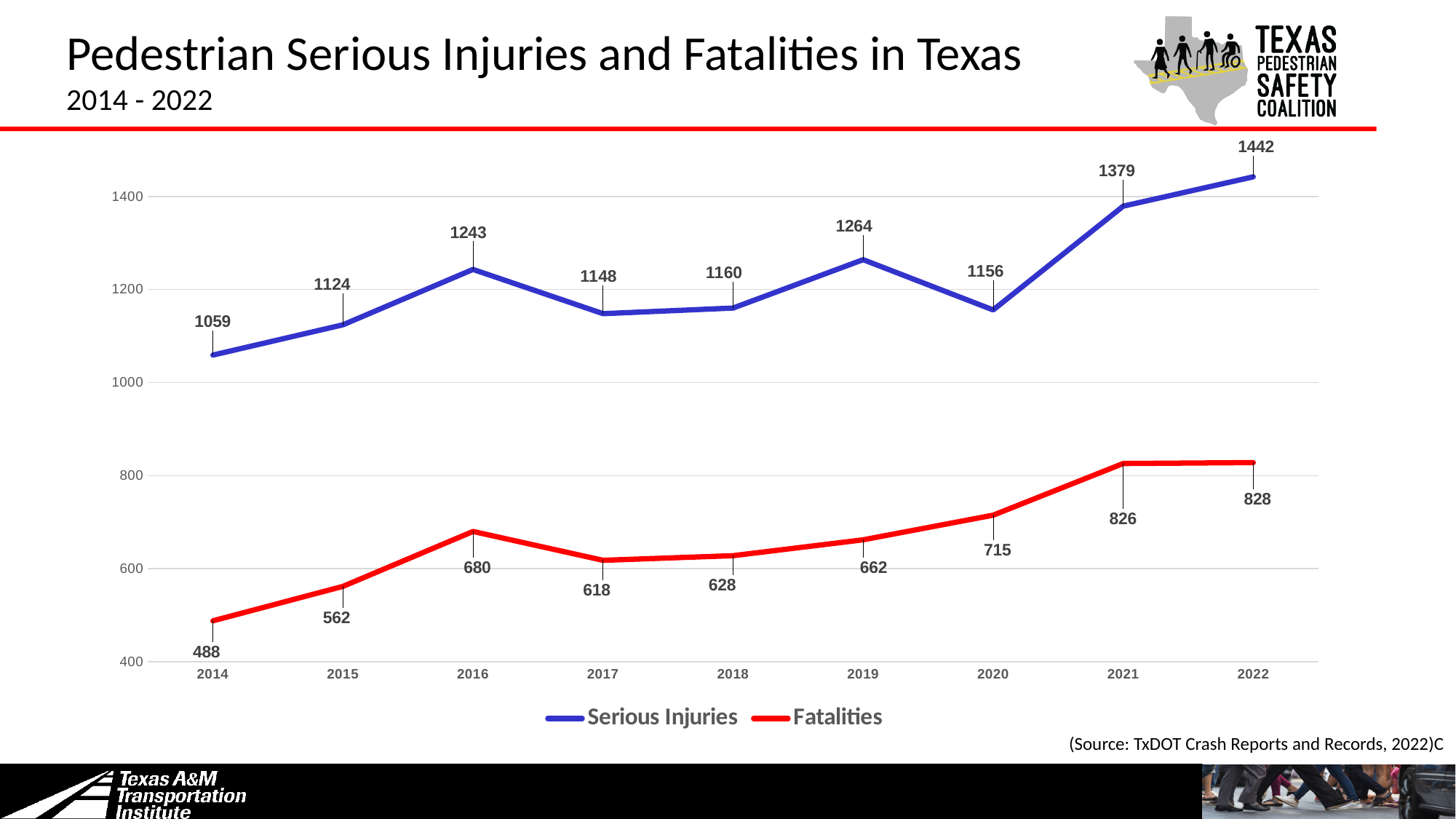
What colour is the Fatalities line? Red What was the number of Fatalities in 2020? 715 What kind of chart is shown on the slide? Line chart What is the difference between Serious Injuries and Fatalities in 2022? 614 Which year had more Serious Injuries, 2019 or 2020? 2019 In which year were Fatalities lowest? 2014 Is the value for Fatalities in 2021 greater or less than 800? greater How many years are shown on the x axis? 9 How many series does the legend list? 2 In which year were Serious Injuries highest? 2022 What was the number of Serious Injuries in 2016? 1243 By how much did Fatalities increase from 2014 to 2022? 340